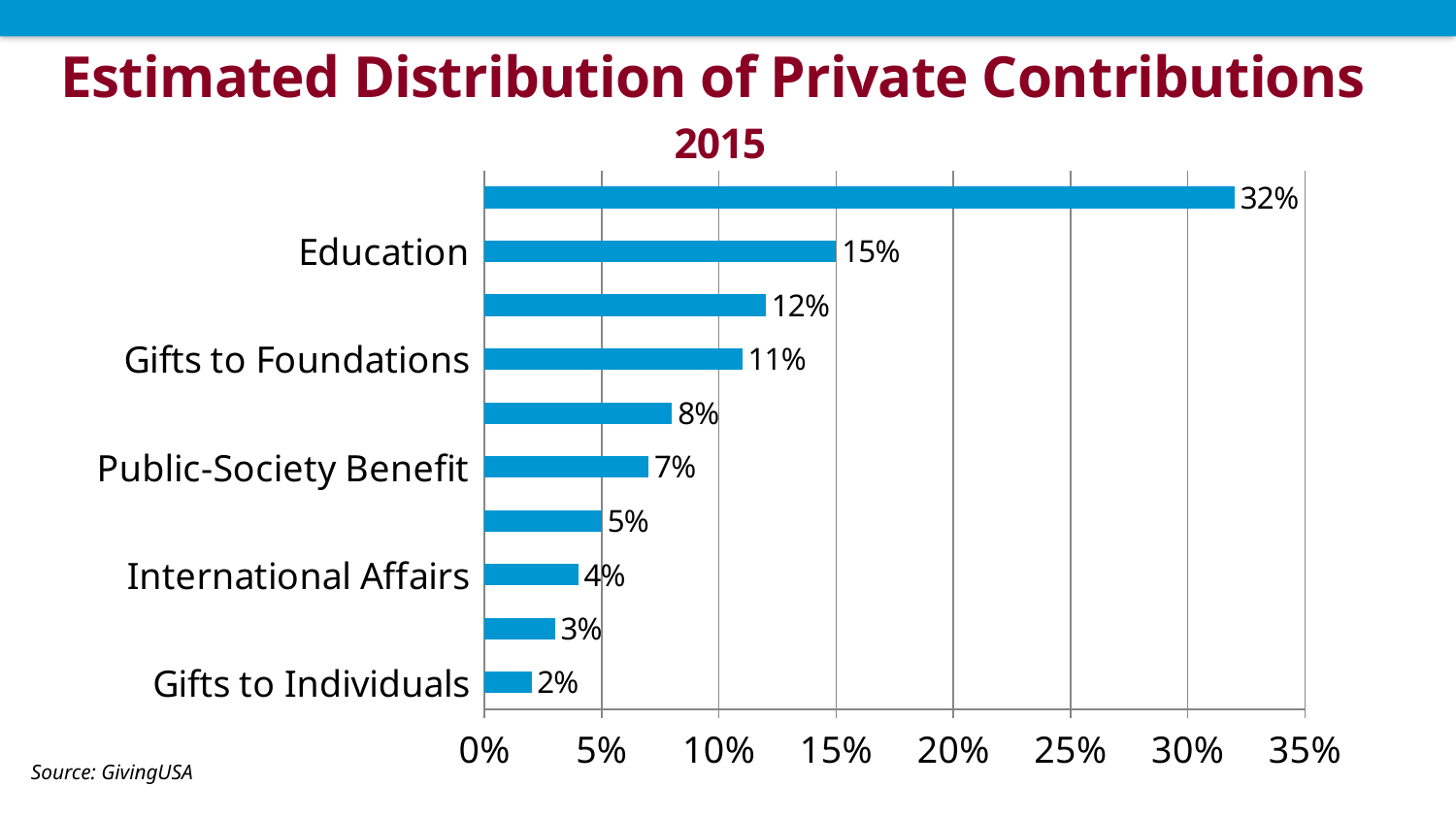
What is the value for International Affairs? 4% What is the difference between the values for Education and Gifts to Foundations? 4% What year does the chart cover, according to its subtitle? 2015 What is the value for Education? 15% What is the highest value shown on the chart? 32% What is the value for Public-Society Benefit? 7% Which labeled category has the lowest value? Gifts to Individuals What kind of chart is shown on the slide? Bar chart What is the value for Gifts to Foundations? 11% Which is larger, the value for Public-Society Benefit or the value for International Affairs? Public-Society Benefit What is the value for Gifts to Individuals? 2% How many bars are plotted on the chart? 10